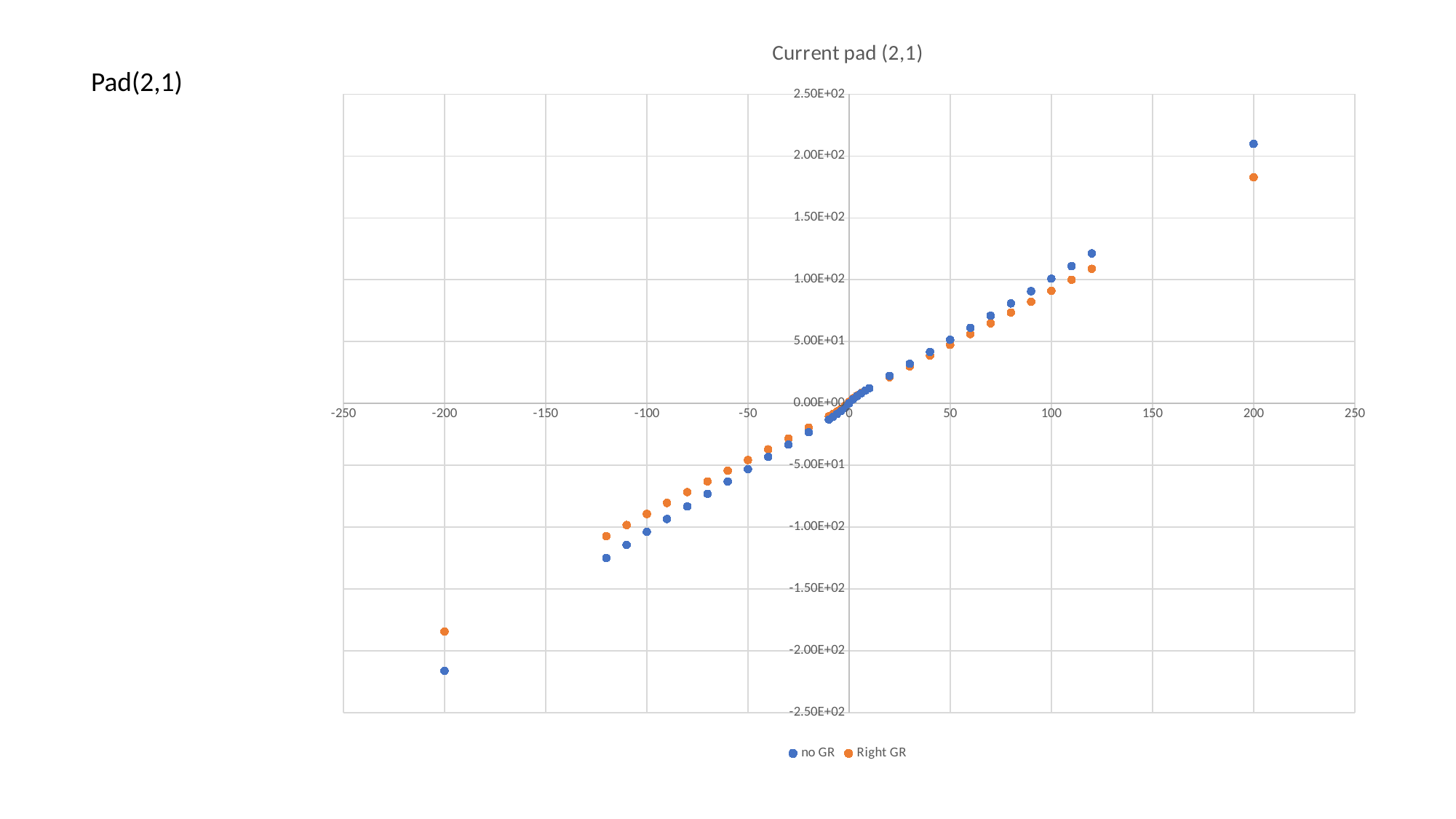
What is the title of the chart? Current pad (2,1) Do the plotted values rise or fall as x increases from -200 to 200? rise What kind of chart is shown on the slide? scatter chart At x = 200, which series has the larger value, no GR or Right GR? no GR Is the value of the Right GR series at x = -200 greater or less than -2.00E+02? greater Is the value of the no GR series at x = -200 greater or less than -2.00E+02? less Which series reaches the highest value on the chart? no GR Is the value of the Right GR series at x = 200 greater or less than 2.00E+02? less How many series does the legend list? 2 Which series is shown in orange in the legend? Right GR